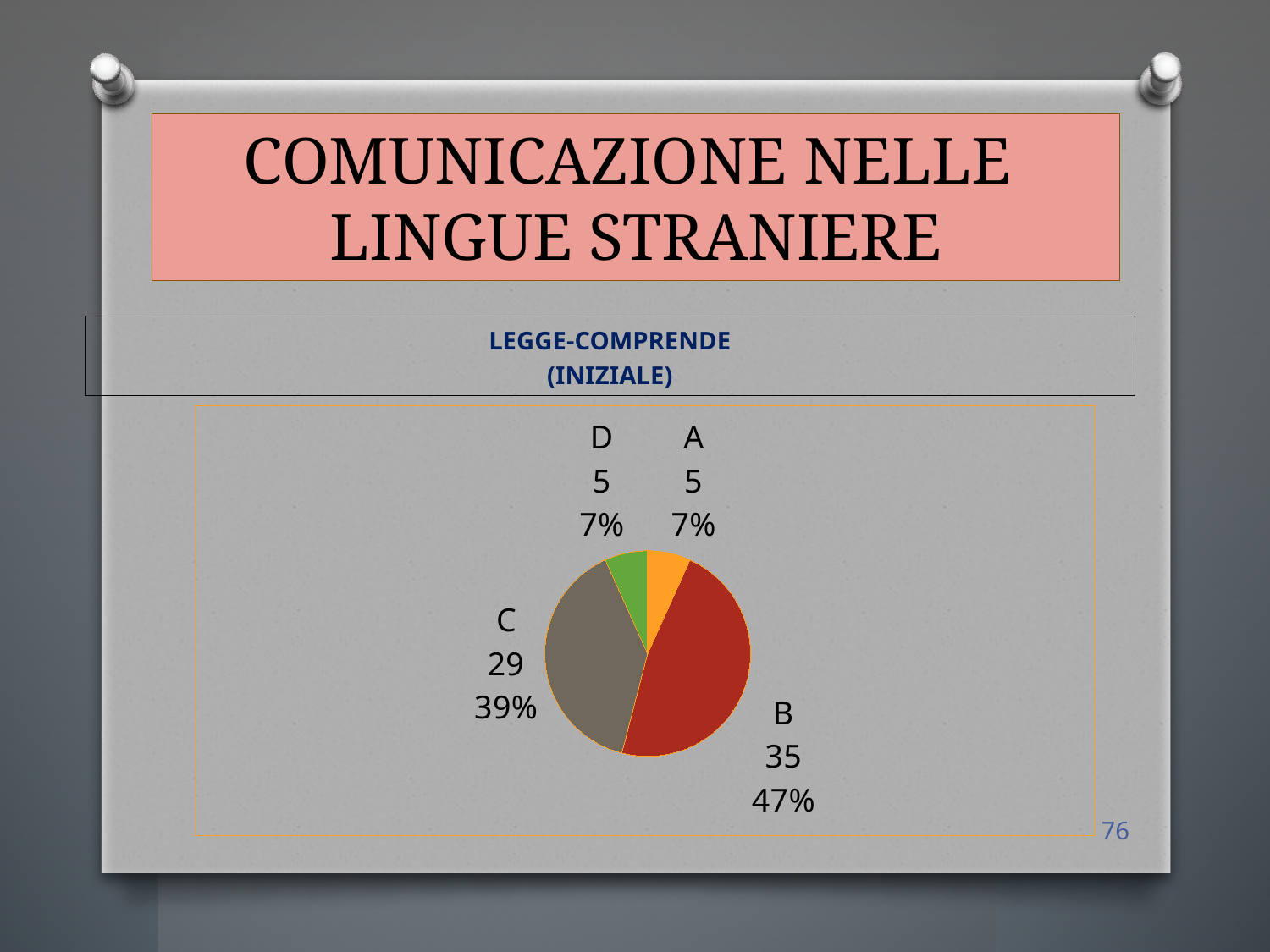
What is the difference between the values for B and C? 6 What is the title of the chart? LEGGE-COMPRENDE (INIZIALE) What is the total of all the values shown in the pie chart? 74 What type of chart is shown on the slide? pie chart What percentage share does category C have? 39% How many categories are shown in the pie chart? 4 What colour is the slice for category B? red What percentage share does category A have? 7% Which category has the largest slice? B Which is larger, the value for C or the value for D? C What is the value for category B? 35 What is the value for category C? 29